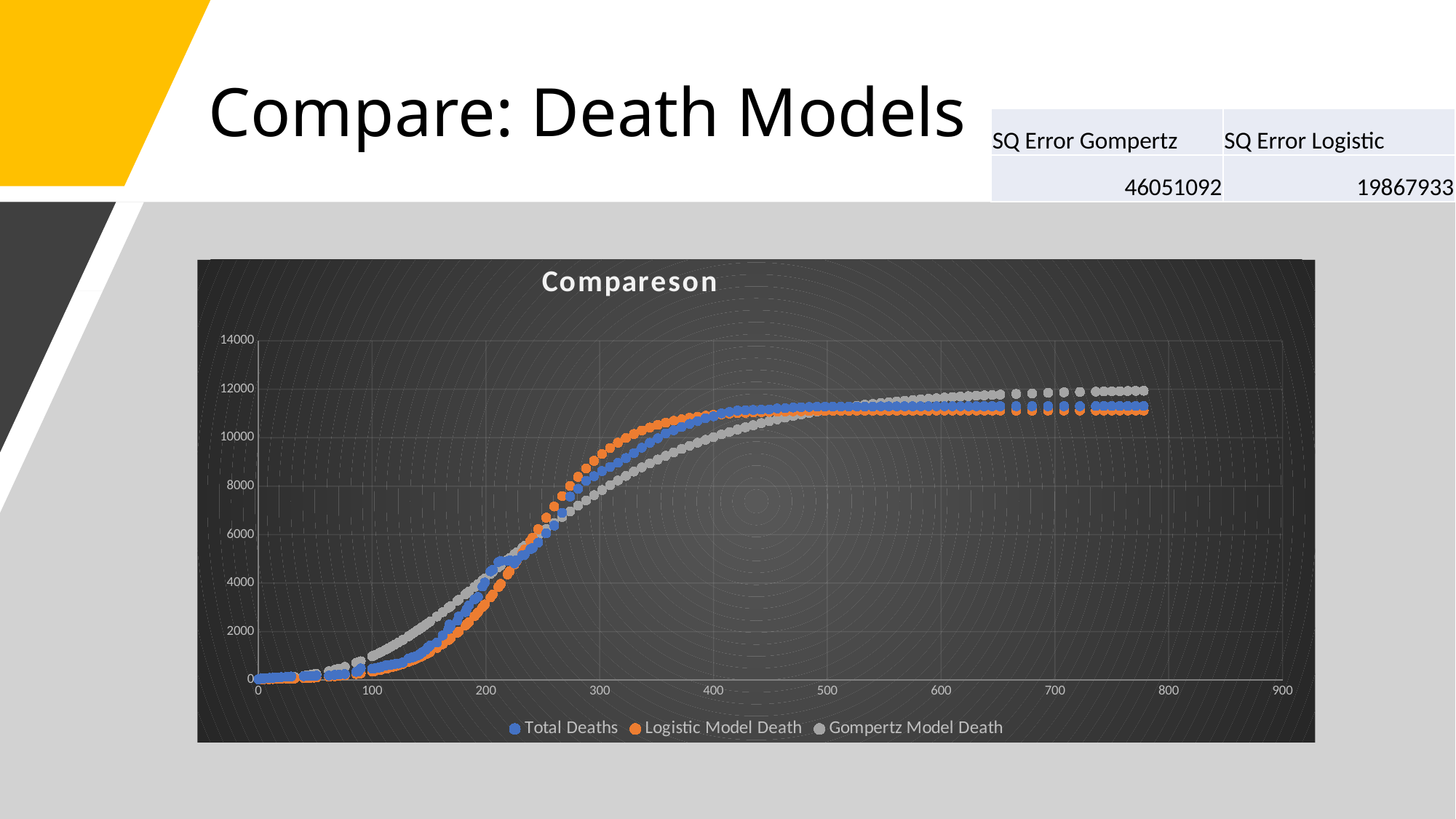
Which series reaches the highest value at the right end of the chart? Gompertz Model Death Is the value of Total Deaths at x = 300 greater or less than 8000? greater Is the value of Logistic Model Death at x = 100 greater or less than 2000? less Is the value of Gompertz Model Death at x = 600 greater or less than 10000? greater What kind of chart is shown on the slide? scatter chart At x = 700, which is larger: Gompertz Model Death or Logistic Model Death? Gompertz Model Death What is the title of the chart? Compareson How many series does the legend of the chart list? 3 At x = 150, which is larger: Gompertz Model Death or Total Deaths? Gompertz Model Death Do the values of the Total Deaths series rise or fall as x increases? rise Which colour represents the Gompertz Model Death series? gray